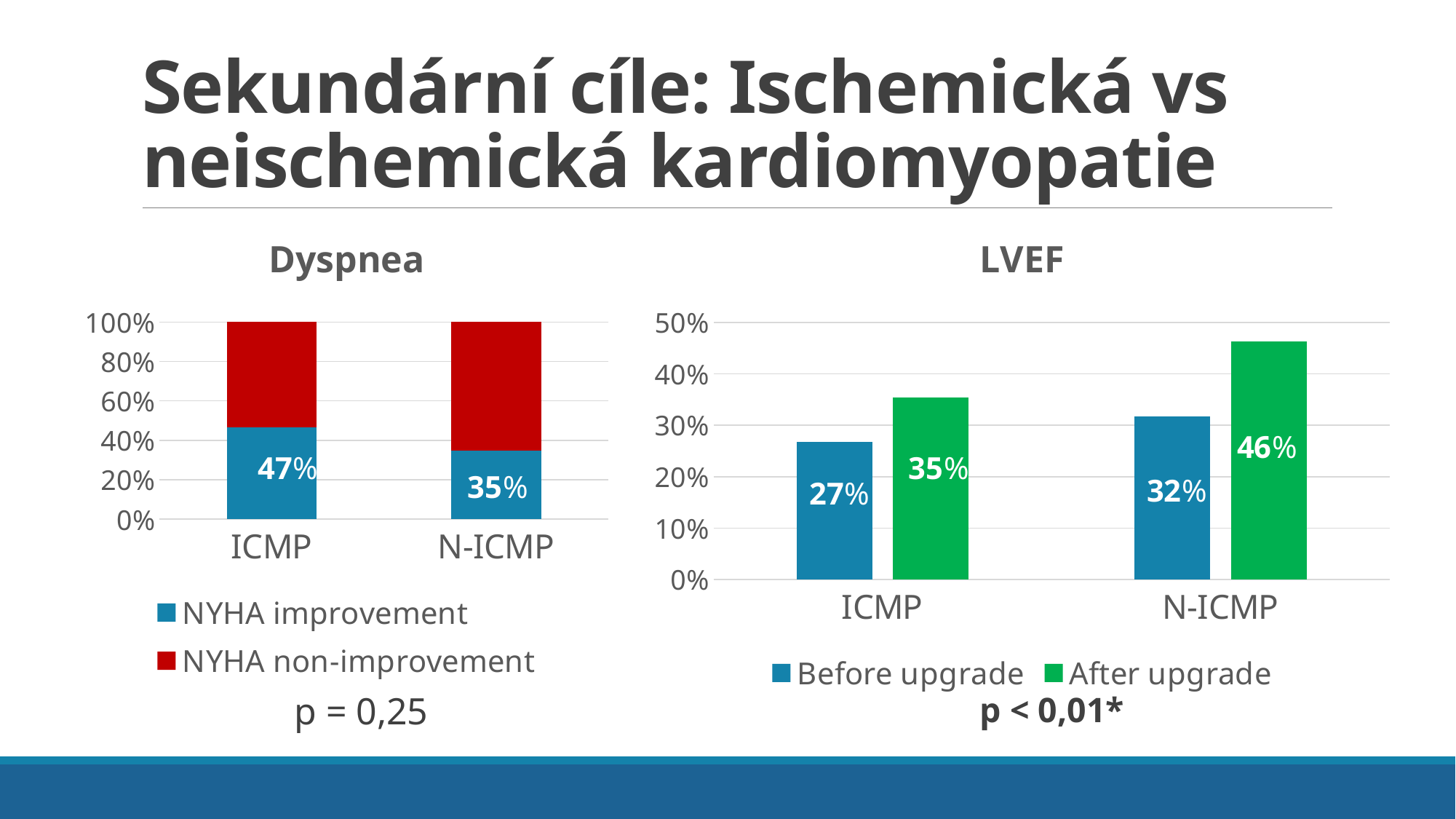
In the Dyspnea chart, what is the NYHA improvement value for N-ICMP? 35% In the Dyspnea chart, what colour represents NYHA non-improvement? Red In the Dyspnea chart, which category has the higher NYHA improvement value, ICMP or N-ICMP? ICMP In the LVEF chart, which bar has the highest value? After upgrade for N-ICMP In the Dyspnea chart, how many series does the legend list? 2 What kind of chart is the LVEF chart? Bar chart In the LVEF chart, which bar has the lowest value? Before upgrade for ICMP In the Dyspnea chart, what is the NYHA improvement value for ICMP? 47% In the Dyspnea chart, what is the difference between the NYHA improvement values for ICMP and N-ICMP? 12% In the LVEF chart, what is the difference between the After upgrade and Before upgrade values for ICMP? 9% In the LVEF chart, what is the Before upgrade value for ICMP? 27% In the LVEF chart, what is the After upgrade value for N-ICMP? 46%